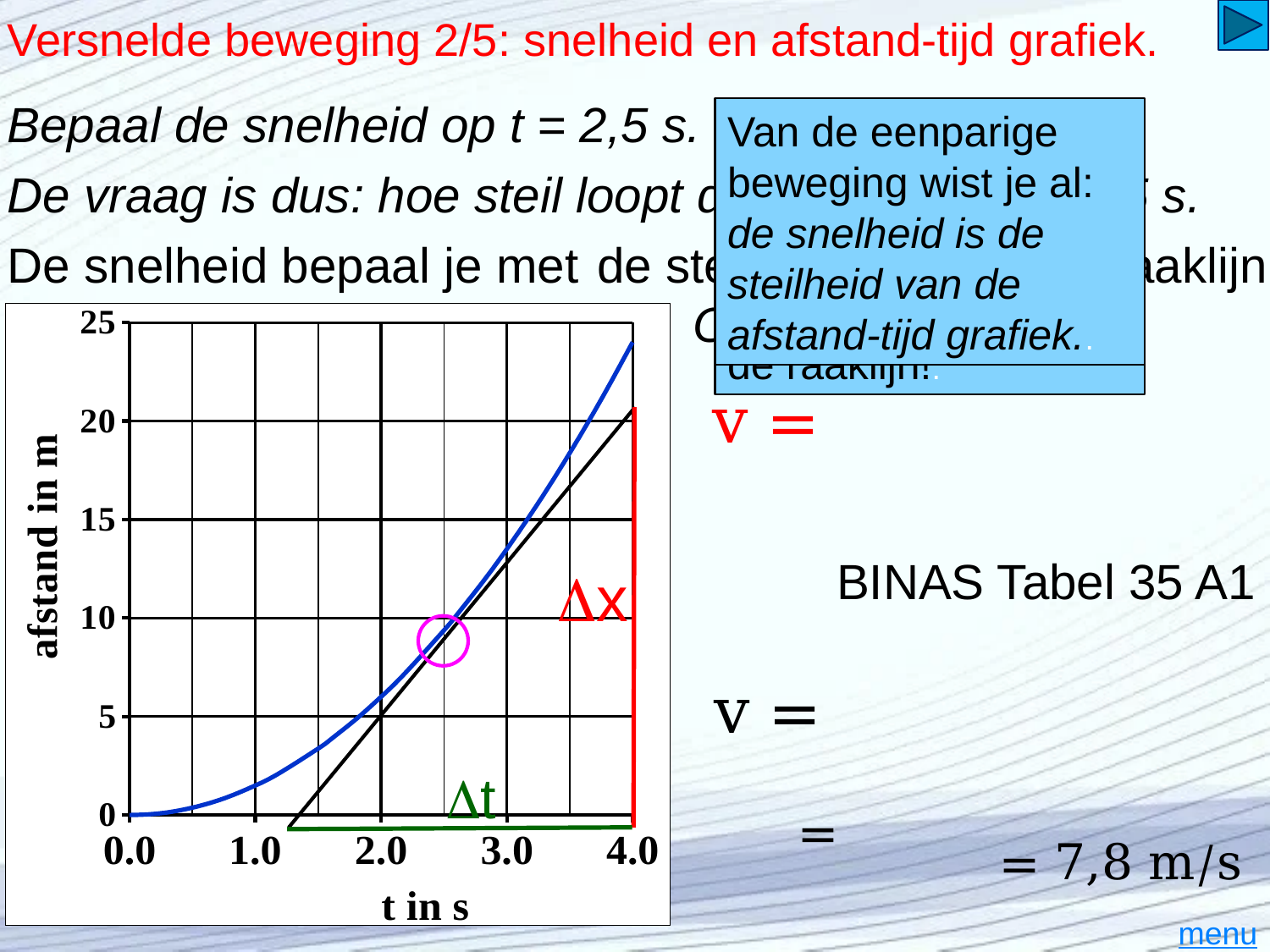
Is the value of the blue curve at t = 3.0 s greater or less than 15? less What kind of chart is shown on the slide? line chart What is the highest value shown on the vertical axis of the chart? 25 What is the label of the horizontal axis of the chart? t in s Is the value of the blue curve at t = 4.0 s greater or less than 20? greater How many labelled tick marks are there on the horizontal axis of the chart? 5 What is the label of the vertical axis of the chart? afstand in m Which is larger: the value of the blue curve at t = 2.0 s or at t = 4.0 s? t = 4.0 s Does the blue curve rise or fall as t increases? rises Is the value of the blue curve at t = 1.0 s greater or less than 5? less At which time is the speed determined from the tangent line, according to the slide? t = 2,5 s